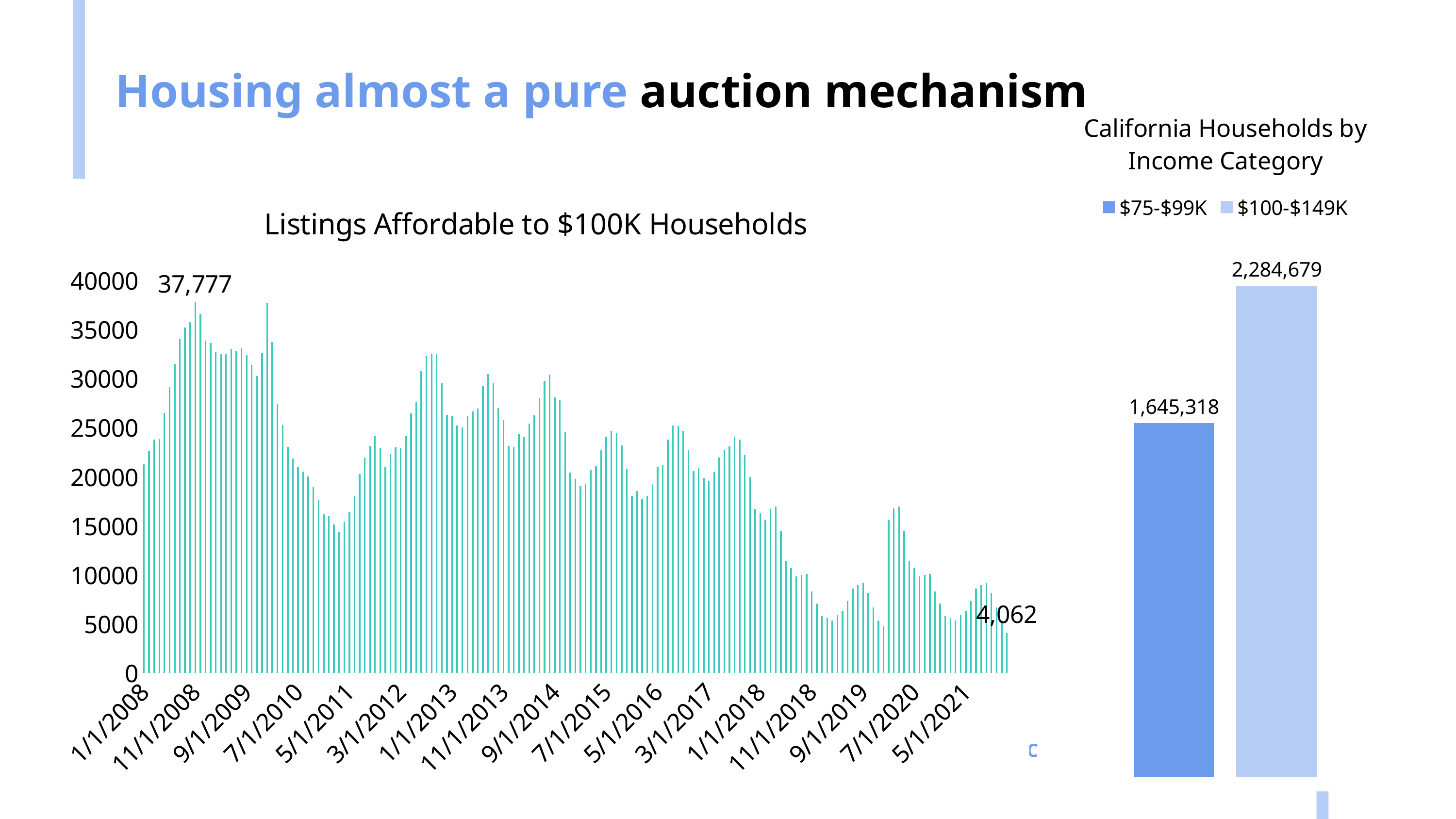
How many series does the legend of the 'California Households by Income Category' chart list? 2 In the 'Listings Affordable to $100K Households' chart, do the values generally rise or fall from 2008 to 2021? fall What kind of chart is the 'Listings Affordable to $100K Households' chart? bar chart What kind of chart is the 'California Households by Income Category' chart? bar chart In the 'Listings Affordable to $100K Households' chart, what is the highest value labeled on the chart? 37,777 In the 'California Households by Income Category' chart, which category has the larger value, $75-$99K or $100-$149K? $100-$149K What is the title of the chart on the left side of the slide? Listings Affordable to $100K Households In the 'California Households by Income Category' chart, what is the difference between the $100-$149K and $75-$99K values? 639,361 In the 'California Households by Income Category' chart, what is the value for the $75-$99K category? 1,645,318 In the 'Listings Affordable to $100K Households' chart, is the value at 5/1/2021 greater or less than 10000? less In the 'Listings Affordable to $100K Households' chart, what value is labeled on the final bar at the right end of the series? 4,062 In the 'California Households by Income Category' chart, what is the value for the $100-$149K category? 2,284,679